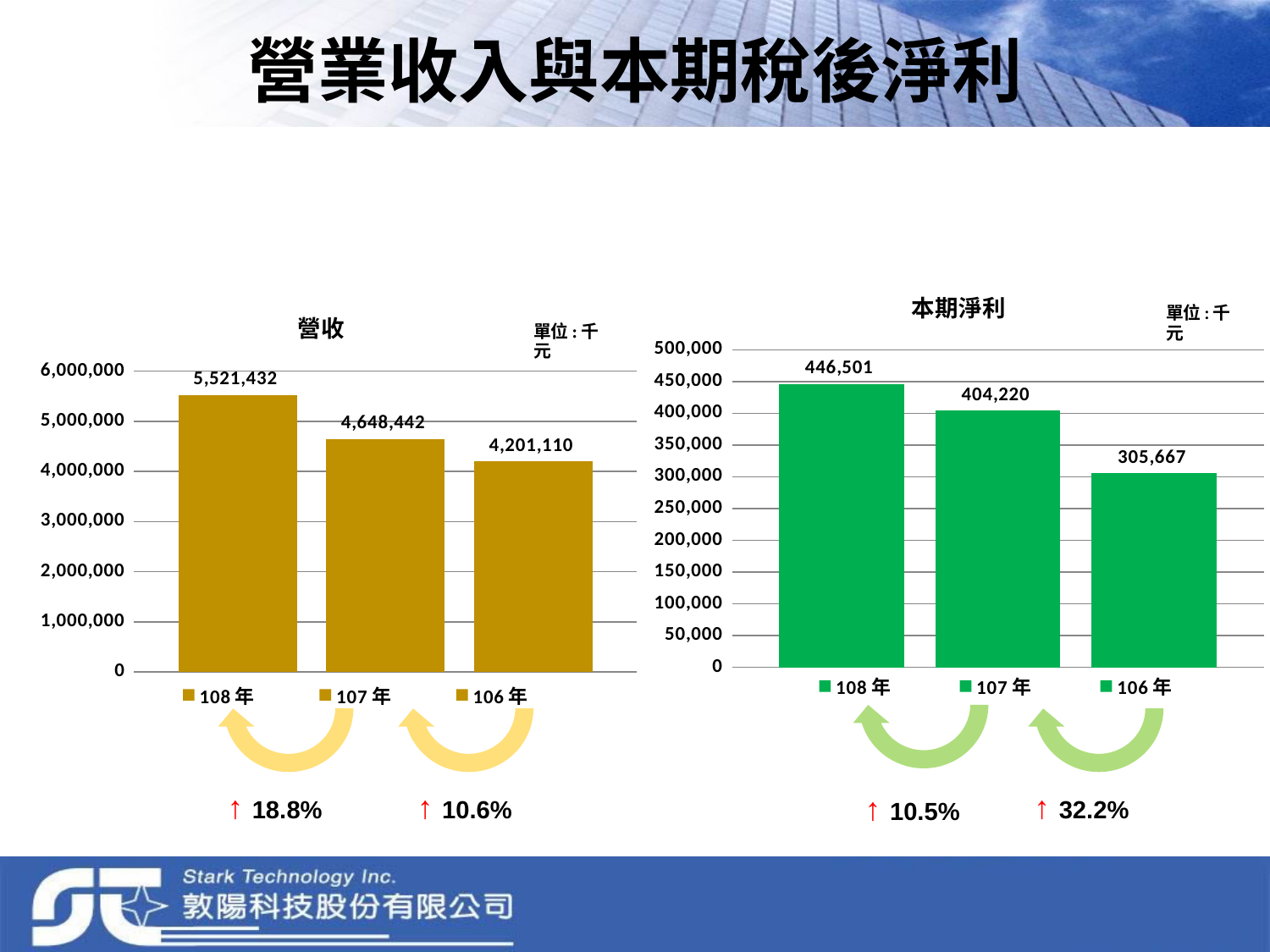
In the 營收 chart, which year has the highest value? 108 年 In the 本期淨利 chart, what is the value for 106 年? 305,667 In the 本期淨利 chart, what is the difference between the values for 107 年 and 106 年? 98,553 What kind of chart is the 營收 chart? bar chart In the 本期淨利 chart, which is larger, the value for 108 年 or 107 年? 108 年 How many bars are in the 本期淨利 chart? 3 In the 營收 chart, is the value for 107 年 greater or less than 5,000,000? less In the 本期淨利 chart, what is the value for 107 年? 404,220 In the 本期淨利 chart, which year has the lowest value? 106 年 In the 營收 chart, what is the value for 108 年? 5,521,432 In the 營收 chart, what is the difference between the values for 108 年 and 107 年? 872,990 In the 營收 chart, what is the value for 106 年? 4,201,110